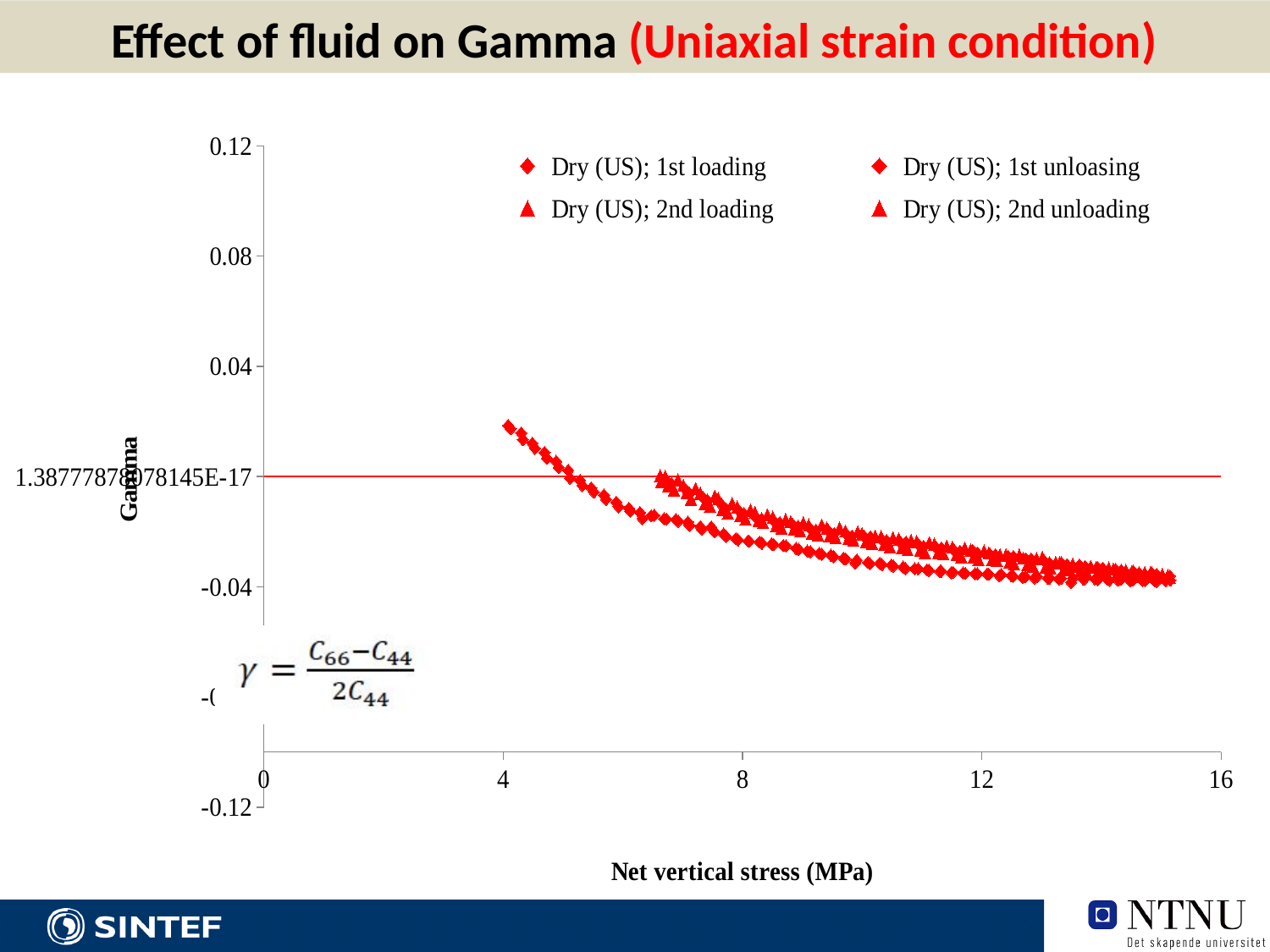
What is the title of the x axis of the chart? Net vertical stress (MPa) Is the largest net vertical stress plotted on the chart greater or less than 16 MPa? less How many series does the chart legend list? 4 What is the maximum value shown on the y axis of the chart? 0.12 As net vertical stress increases, do the Gamma values rise or fall? Fall Is the Gamma value for Dry (US); 1st loading at about 4 MPa greater or less than -0.04? greater What is the title of the y axis of the chart? Gamma Is the Gamma value for Dry (US); 2nd loading at about 12 MPa greater or less than 0.04? less What kind of chart is shown on the slide? Scatter chart